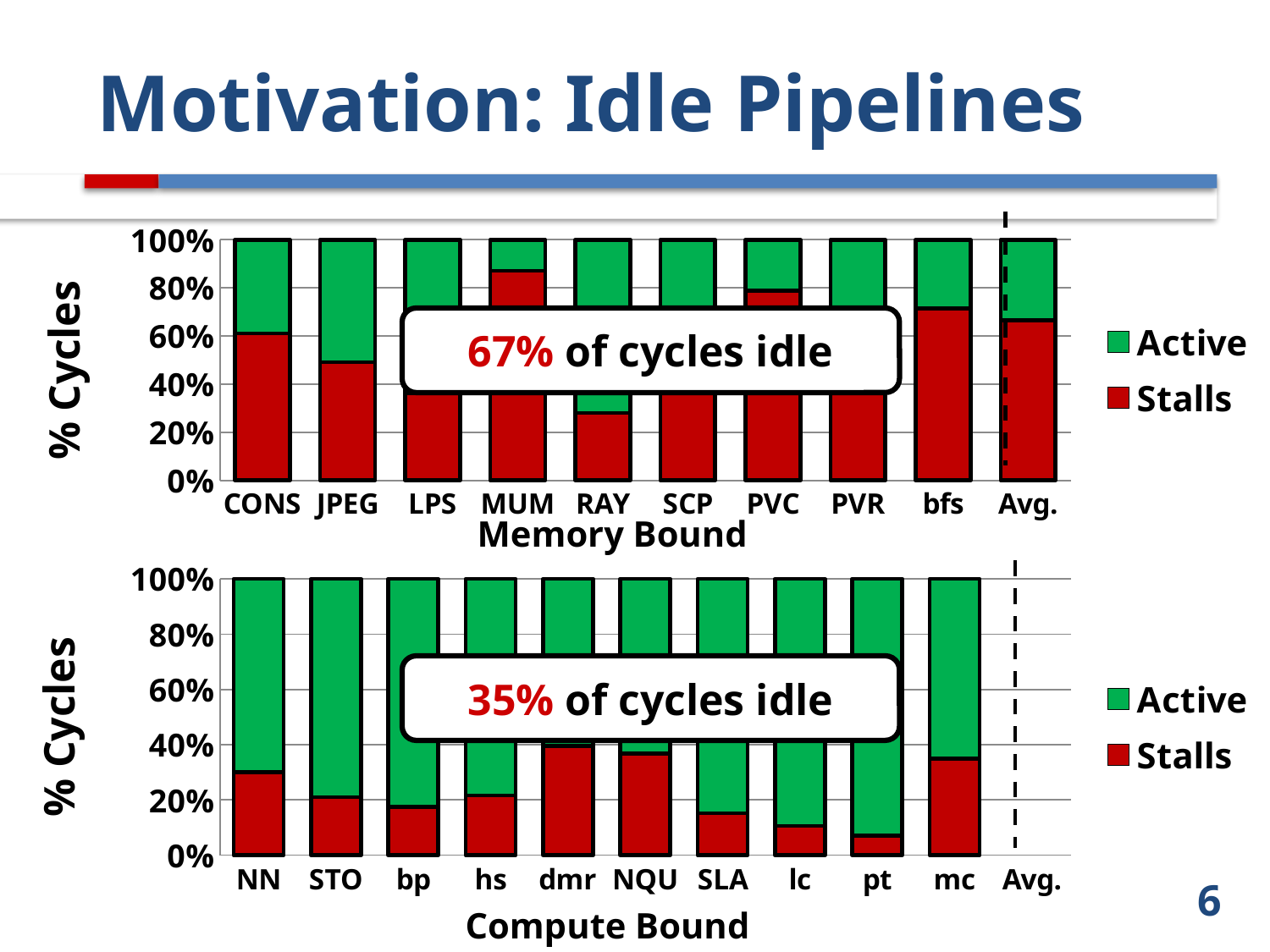
In the Compute Bound chart, which category has the smallest Stalls share? pt What are the two legend entries on the Memory Bound chart? Active, Stalls In the Memory Bound chart, which category has the smallest Stalls share? RAY According to the callout on the Compute Bound chart, what percentage of cycles are idle? 35% In the Compute Bound chart, is the Stalls value for NN greater or less than 20%? greater In the Memory Bound chart, is the Stalls value for CONS greater or less than 40%? greater In the Compute Bound chart, is the Stalls value for pt greater or less than 20%? less How many categories are shown on the x axis of the Memory Bound chart? 10 How many series does the legend of the Compute Bound chart list? 2 In the Memory Bound chart, which category has the largest Stalls share? MUM What kind of chart is the Memory Bound chart? bar chart In the Memory Bound chart, which has the larger Stalls share, CONS or JPEG? CONS